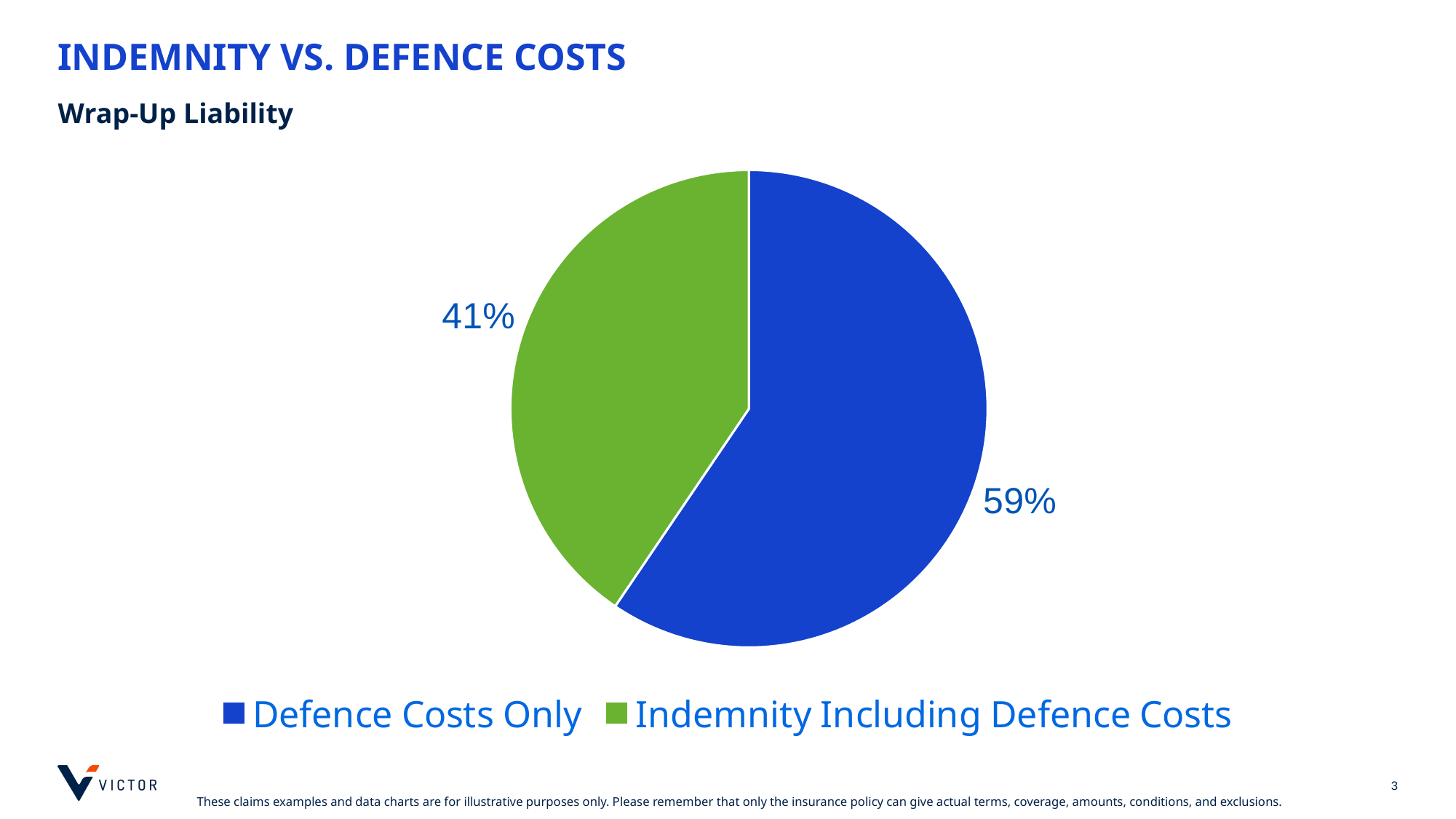
What kind of chart is shown on the slide? Pie chart What is the title of the slide containing the chart? INDEMNITY VS. DEFENCE COSTS Which is larger, Defence Costs Only or Indemnity Including Defence Costs? Defence Costs Only What share of the pie is Indemnity Including Defence Costs? 41% What share of the pie is Defence Costs Only? 59% What colour is the Indemnity Including Defence Costs slice? Green How many entries does the legend list? 2 Is the share for Defence Costs Only greater or less than 50%? greater Which slice is the largest? Defence Costs Only What is the difference in percentage points between Defence Costs Only and Indemnity Including Defence Costs? 18 Which slice is the smallest? Indemnity Including Defence Costs How many slices does the pie chart have? 2